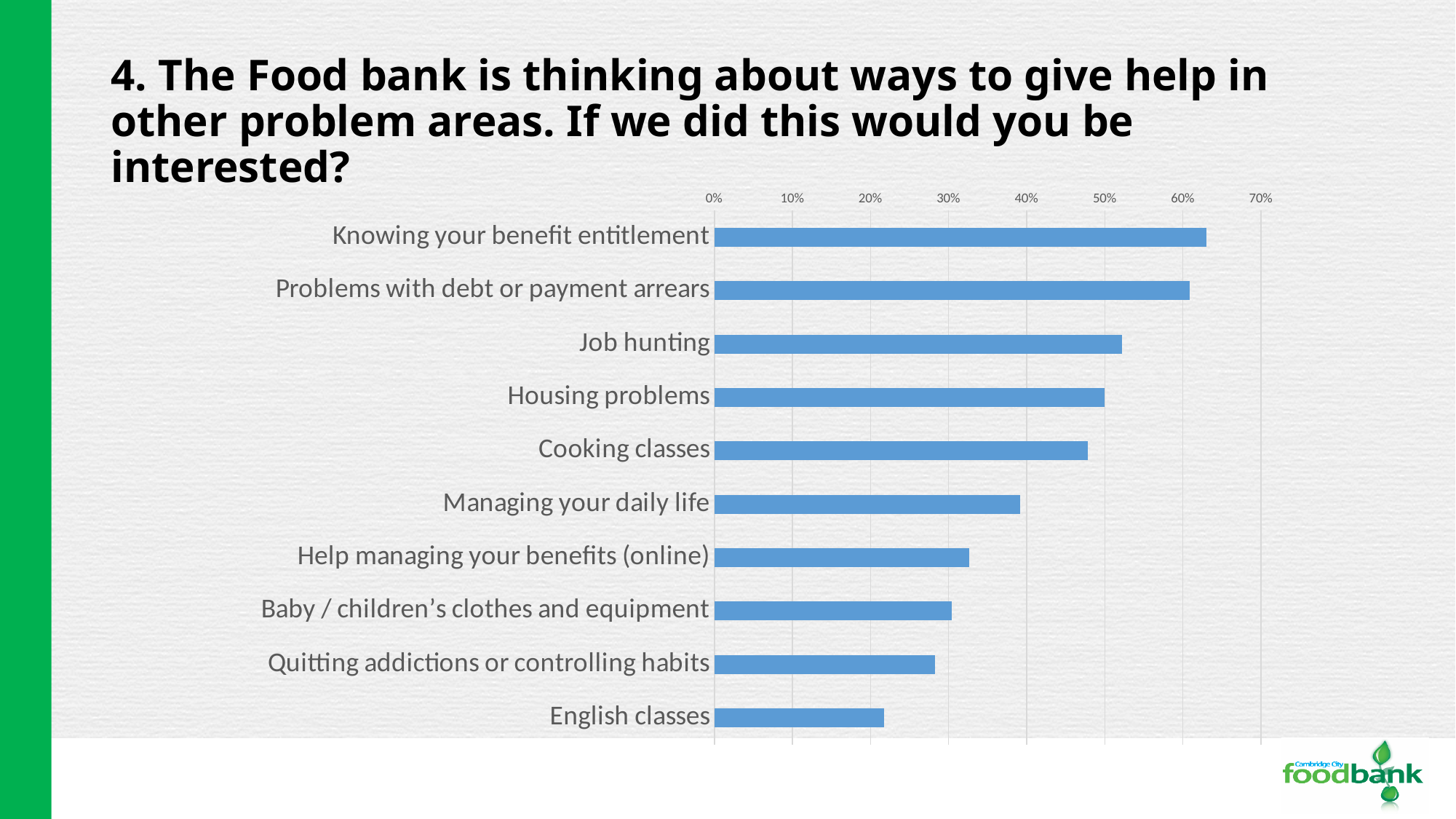
Is the value for Cooking classes greater or less than 50%? less Which is larger, the value for Job hunting or the value for Cooking classes? Job hunting Is the value for English classes greater or less than 30%? less Is the value for Knowing your benefit entitlement greater or less than 60%? greater Which category has the highest value in the chart? Knowing your benefit entitlement What is the highest value shown on the percentage axis of the chart? 70% Which category has the lowest value in the chart? English classes What kind of chart is shown on the slide? bar chart How many categories (problem areas) are shown in the chart? 10